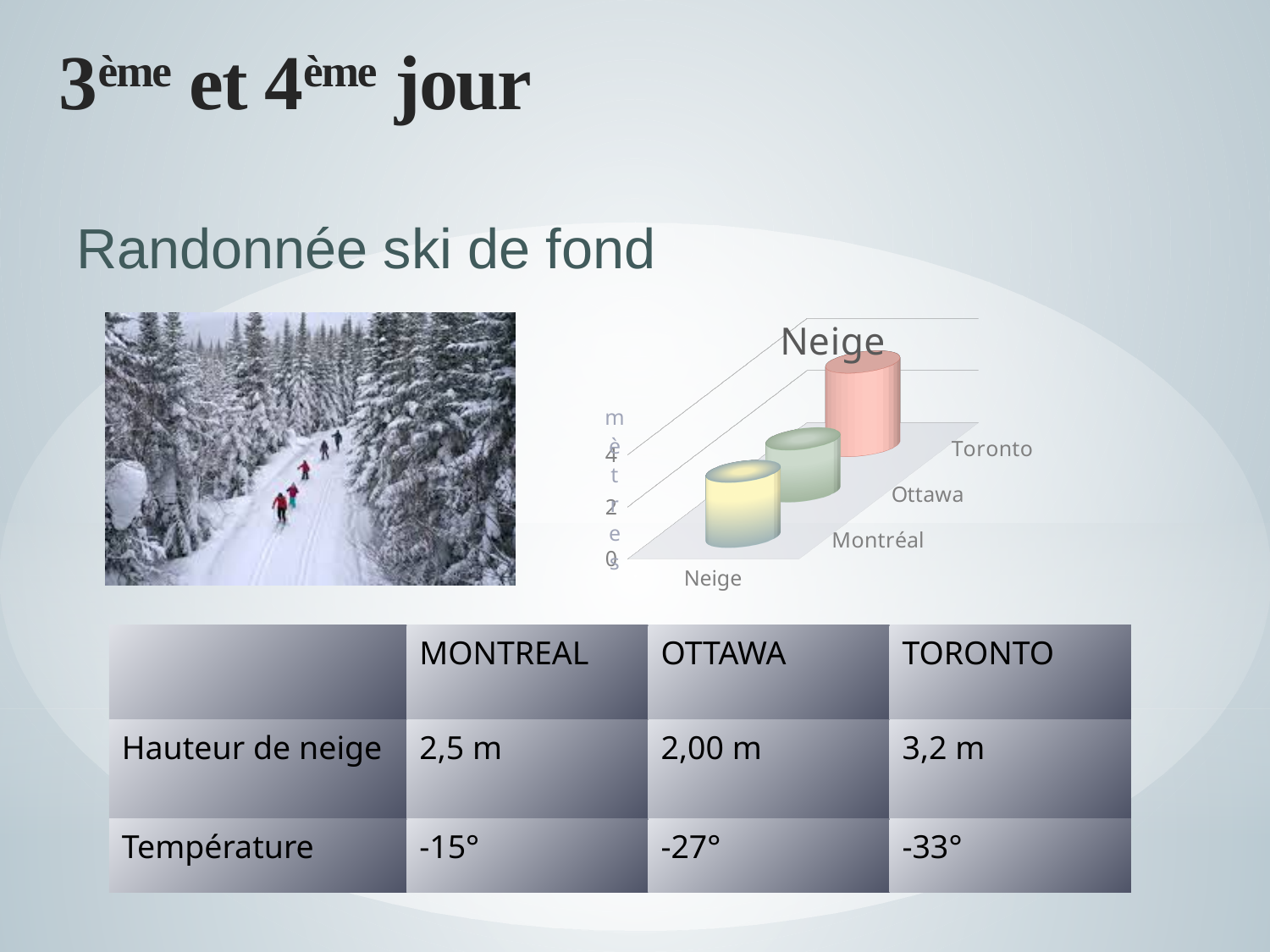
What is the highest tick value shown on the vertical axis of the Neige chart? 4 In the Neige chart, which bar is taller: Montréal or Toronto? Toronto What kind of chart is shown on the slide? bar chart Which city is listed first (closest to the front) on the category axis of the Neige chart? Montréal How many cities are plotted in the Neige chart? 3 Is the value for Toronto in the Neige chart greater or less than 2? greater Which city has the highest bar in the Neige chart? Toronto What is the title of the chart? Neige In the Neige chart, is the bar for Toronto taller than the bar for Ottawa? Yes